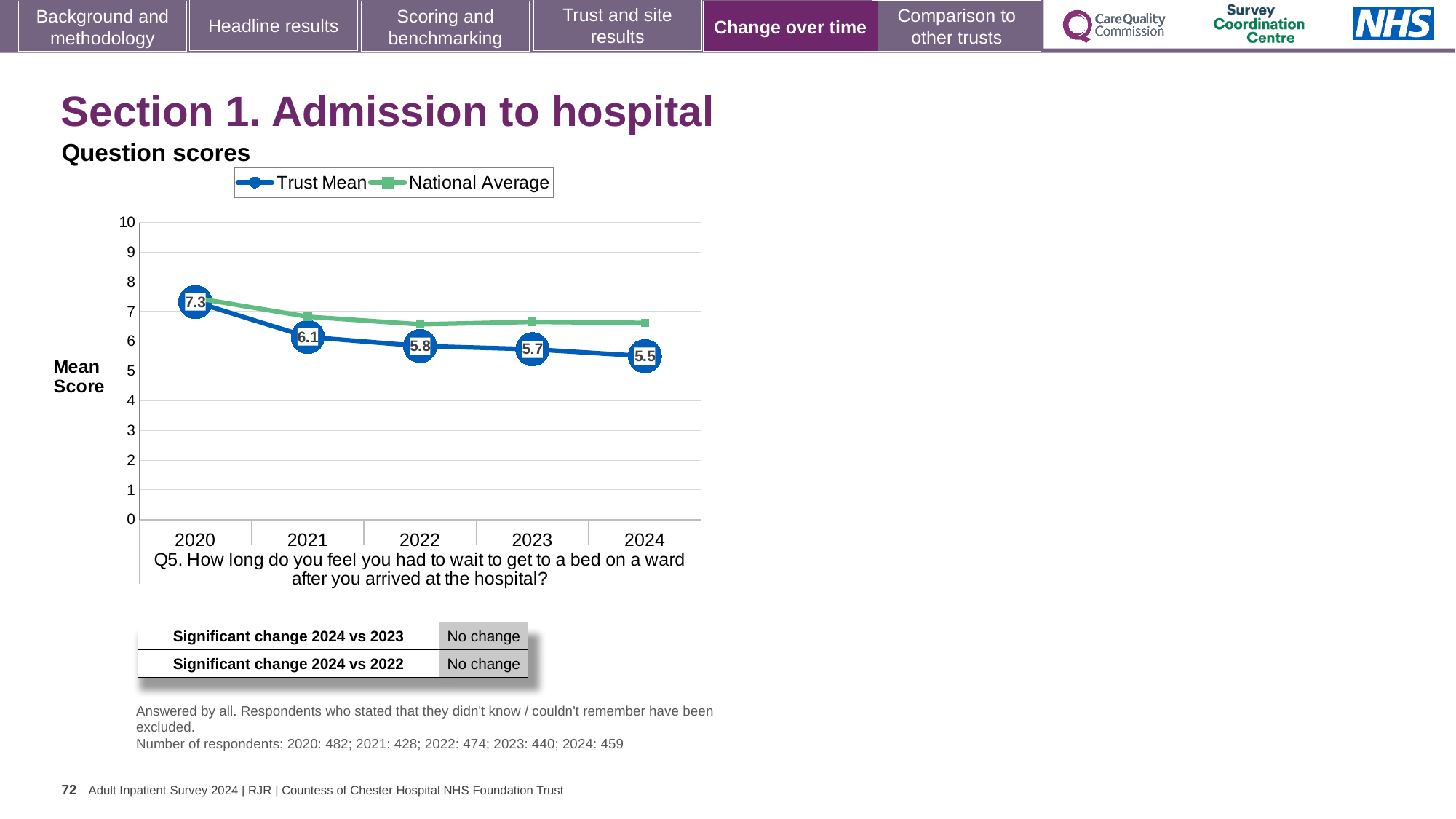
How many series does the legend list? 2 In which year is the Trust Mean lowest? 2024 Which is larger, the Trust Mean in 2021 or in 2023? 2021 Is the National Average for 2021 greater or less than 6? greater In which year is the Trust Mean highest? 2020 What kind of chart is shown? line chart What is the Trust Mean score for 2022? 5.8 What is the difference between the Trust Mean in 2020 and in 2024? 1.8 Does the Trust Mean rise or fall from 2020 to 2024? fall How many years are shown on the x axis? 5 What is the Trust Mean score for 2024? 5.5 What is the Trust Mean score for 2020? 7.3